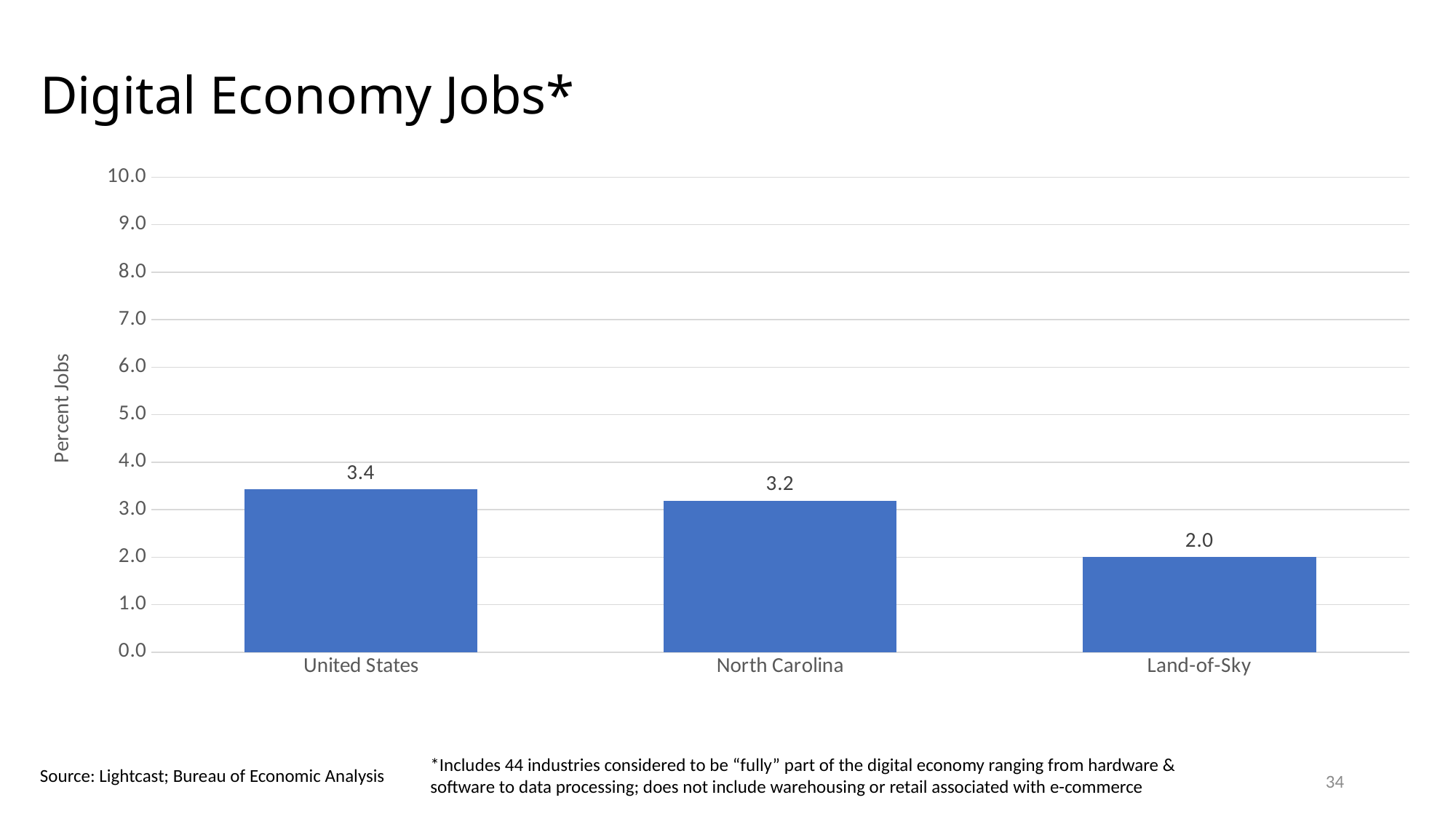
What kind of chart is shown on the slide? bar chart Is the value for United States greater or less than 3.0? greater How many categories are shown on the chart? 3 What is the value for United States? 3.4 Which is larger, the value for North Carolina or the value for Land-of-Sky? North Carolina What is the value for Land-of-Sky? 2.0 What is the difference between the values for North Carolina and Land-of-Sky? 1.2 What is the label of the vertical axis? Percent Jobs Which category has the highest value? United States What is the value for North Carolina? 3.2 Which category has the lowest value? Land-of-Sky What is the difference between the values for United States and Land-of-Sky? 1.4